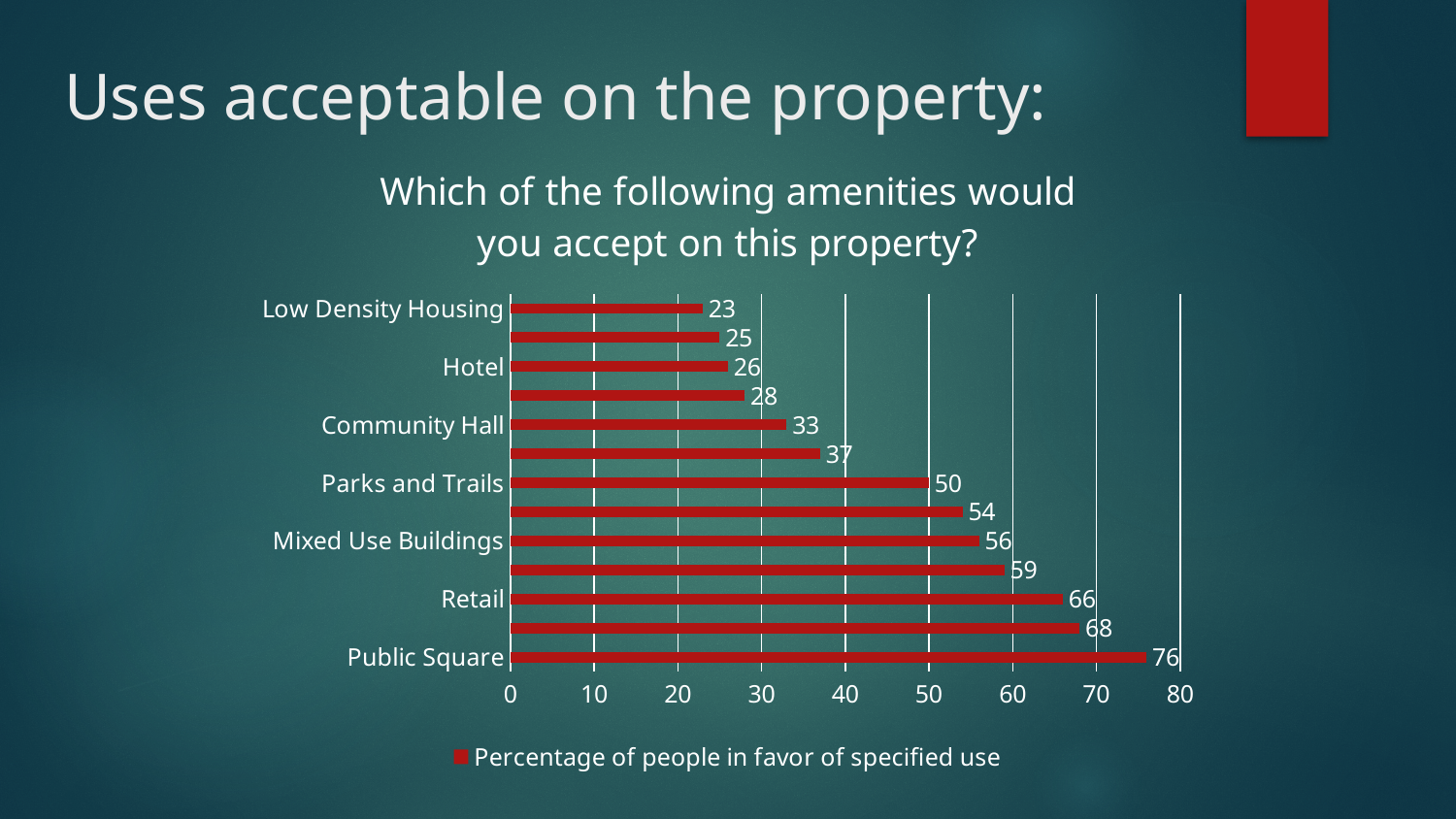
What is the value for Retail? 66 What is the value for Low Density Housing? 23 Which labeled category has the highest value? Public Square What kind of chart is shown on the slide? bar chart How many bars are plotted in the chart? 13 Is the value for Mixed Use Buildings greater or less than 50? greater What is the value for Parks and Trails? 50 What is the difference between the values for Public Square and Retail? 10 What series does the legend list? Percentage of people in favor of specified use Which is larger, the value for Community Hall or the value for Hotel? Community Hall What is the value for Public Square? 76 Which labeled category has the lowest value? Low Density Housing